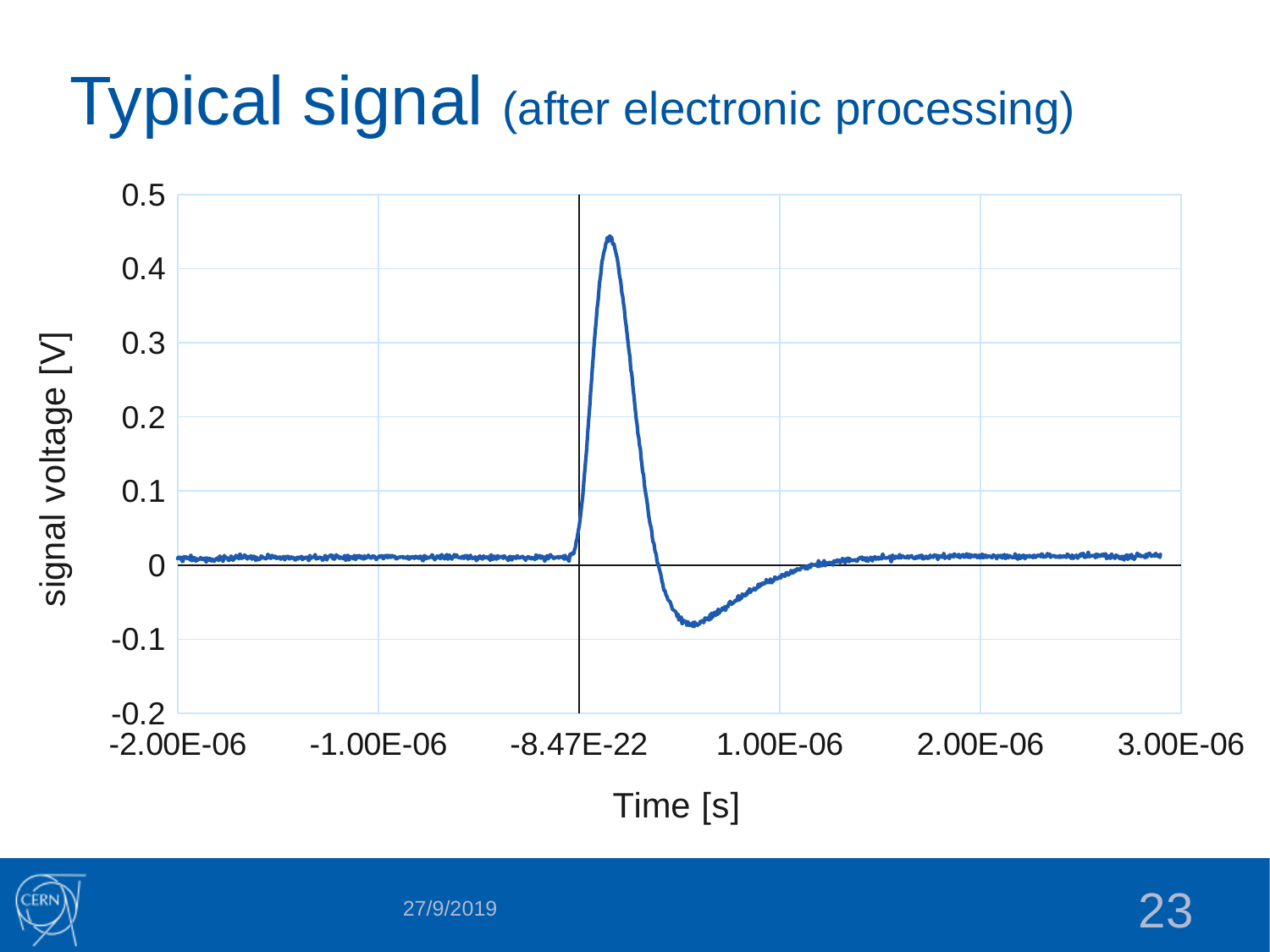
Which is larger, the signal voltage at its peak or the signal voltage at time 1.00E-06 s? the peak Is the peak value of the signal voltage greater or less than 0.4? greater Is the peak value of the signal voltage greater or less than 0.5? less Is the lowest value of the signal voltage greater or less than -0.1? greater What kind of chart is shown on the slide? line chart Does the signal voltage rise or fall between time -8.47E-22 s and its peak? rise What is the label of the x axis of the chart? Time [s] What is the label of the y axis of the chart? signal voltage [V] What is the highest value shown on the y axis of the chart? 0.5